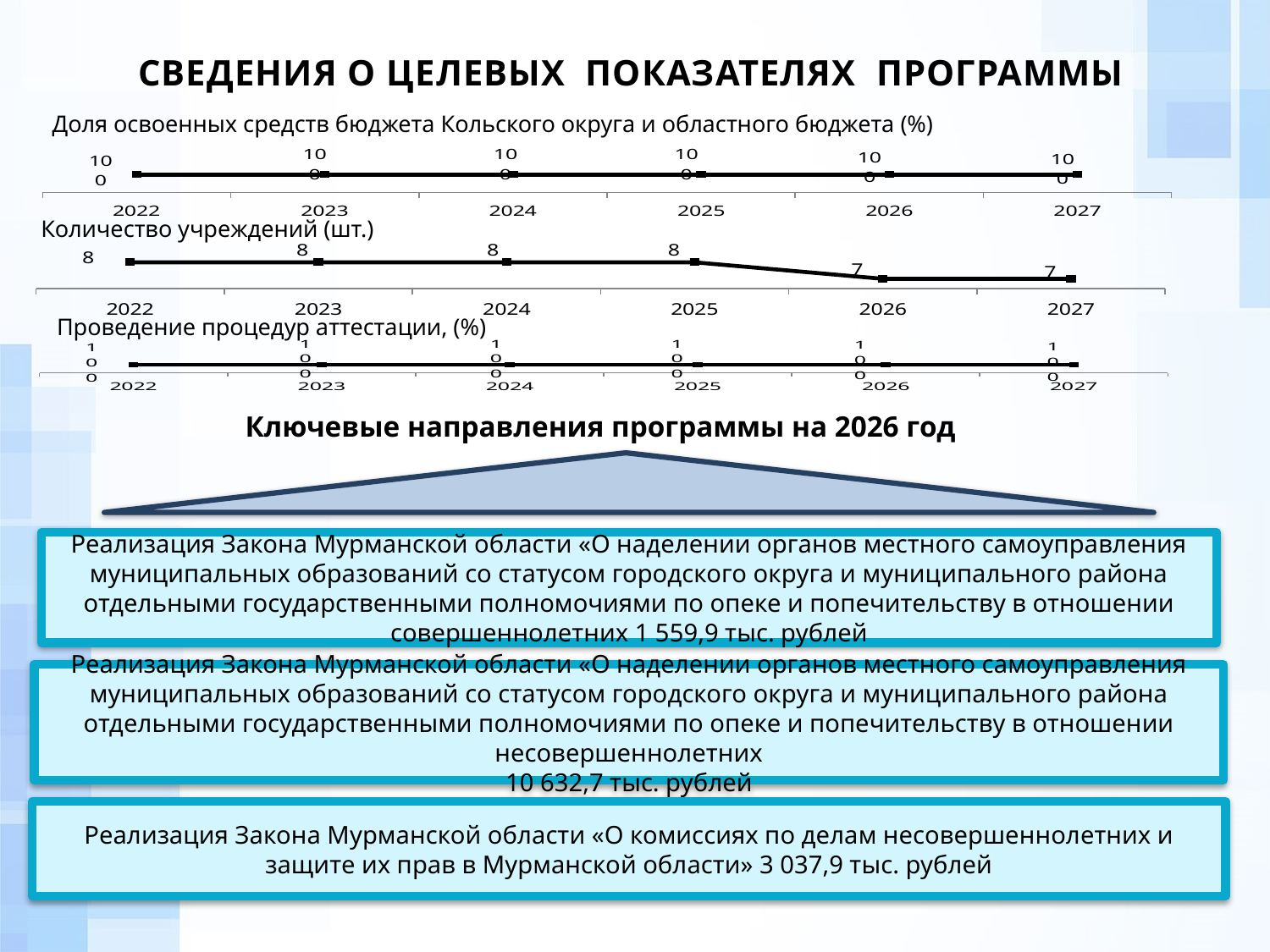
In the chart 'Доля освоенных средств бюджета Кольского округа и областного бюджета (%)', what is the value for 2025? 100 In the chart 'Количество учреждений (шт.)', do the values rise, fall or stay the same from 2022 to 2027? fall In the chart 'Количество учреждений (шт.)', what is the value for 2024? 8 In the chart 'Количество учреждений (шт.)', how many years are plotted on the x axis? 6 In the chart 'Количество учреждений (шт.)', what is the value for 2026? 7 In the chart 'Количество учреждений (шт.)', what is the difference between the values for 2025 and 2026? 1 How many charts are shown on the slide? 3 What kind of chart is 'Количество учреждений (шт.)'? line chart In the chart 'Количество учреждений (шт.)', what is the value for 2027? 7 In the chart 'Количество учреждений (шт.)', which is larger, the value for 2023 or the value for 2027? 2023 In the chart 'Доля освоенных средств бюджета Кольского округа и областного бюджета (%)', do the values rise, fall or stay the same from 2022 to 2027? stay the same In the chart 'Проведение процедур аттестации, (%)', what is the value for 2027? 100